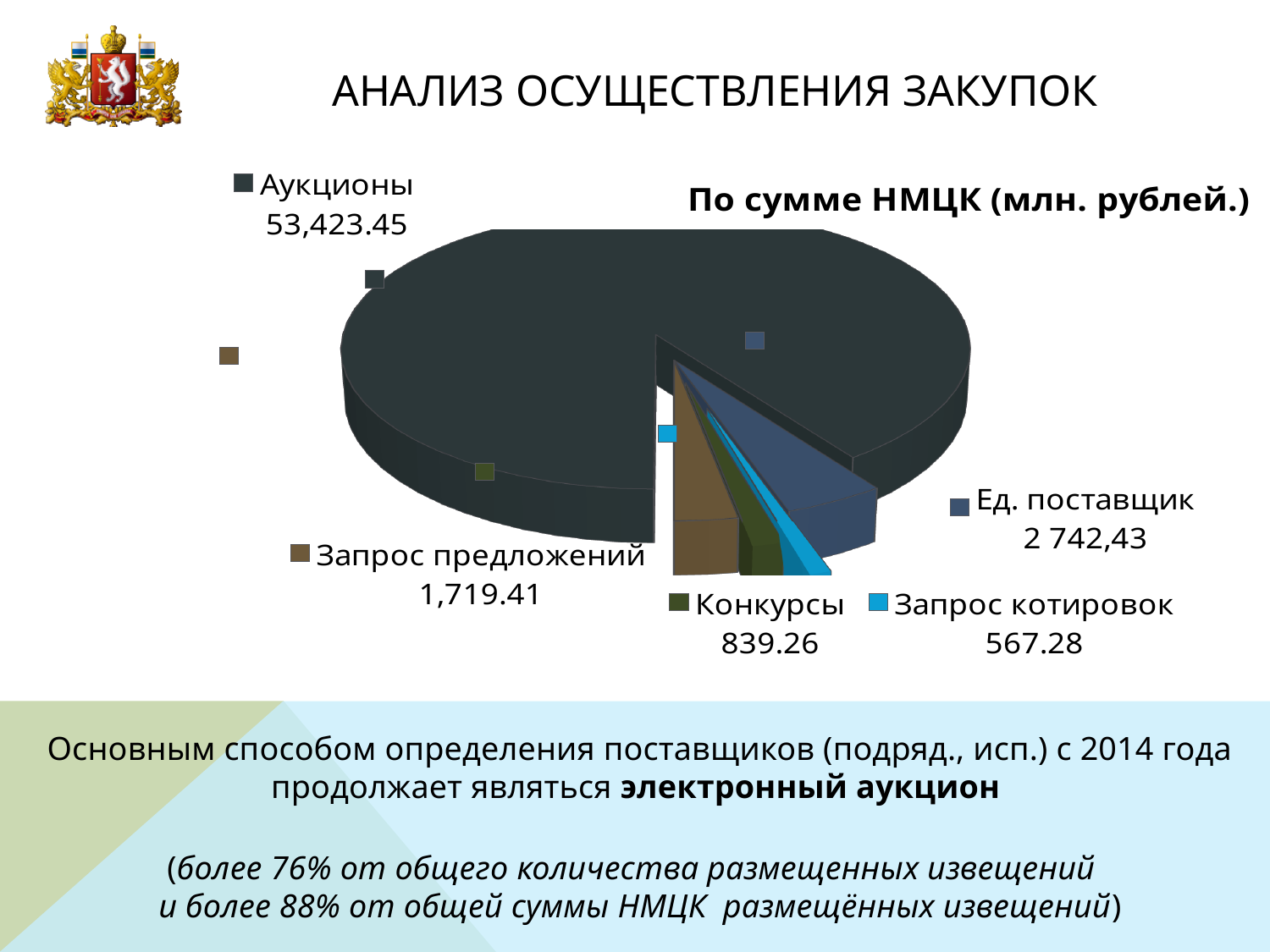
Which is larger, Конкурсы or Запрос котировок? Конкурсы How many categories does the pie chart show? 5 What is the difference between the values for Конкурсы and Запрос котировок? 271.98 What is the value for Ед. поставщик? 2 742,43 Which category has the smallest value? Запрос котировок Which category has the largest value? Аукционы What is the value for Запрос котировок? 567.28 What is the value for Конкурсы? 839.26 What kind of chart is shown on the slide? Pie chart What is the title of the chart? По сумме НМЦК (млн. рублей.) What is the value for Запрос предложений? 1,719.41 What is the value for Аукционы? 53,423.45